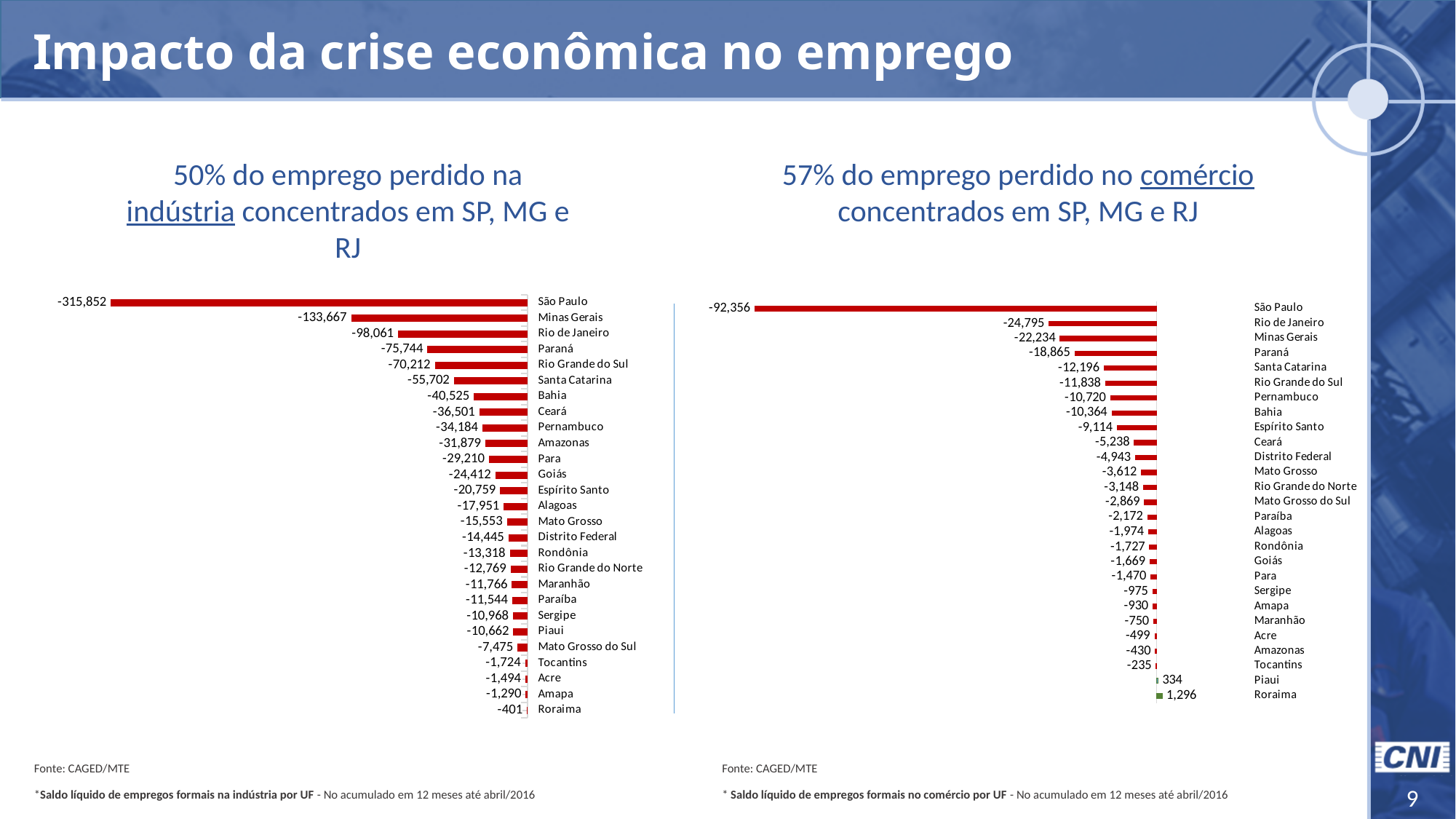
On the left chart (indústria), which state has the lowest (most negative) value? São Paulo On the right chart (comércio), what is the difference between the values for Minas Gerais and Paraná? 3,369 On the left chart (indústria), what is the difference between the values for Minas Gerais and Rio de Janeiro? 35,606 On the left chart (indústria), which has the larger job loss, Paraná or Santa Catarina? Paraná On the right chart (comércio), which state has the highest (most positive) value? Roraima What type of chart is the left chart (indústria)? Bar chart On the right chart (comércio), how many states have a positive value? 2 How many states are shown on the right chart (comércio)? 27 On the left chart (indústria), what is the value for Bahia? -40,525 On the left chart (indústria), what is the value for São Paulo? -315,852 On the right chart (comércio), what is the value for Roraima? 1,296 On the right chart (comércio), what is the value for Rio de Janeiro? -24,795